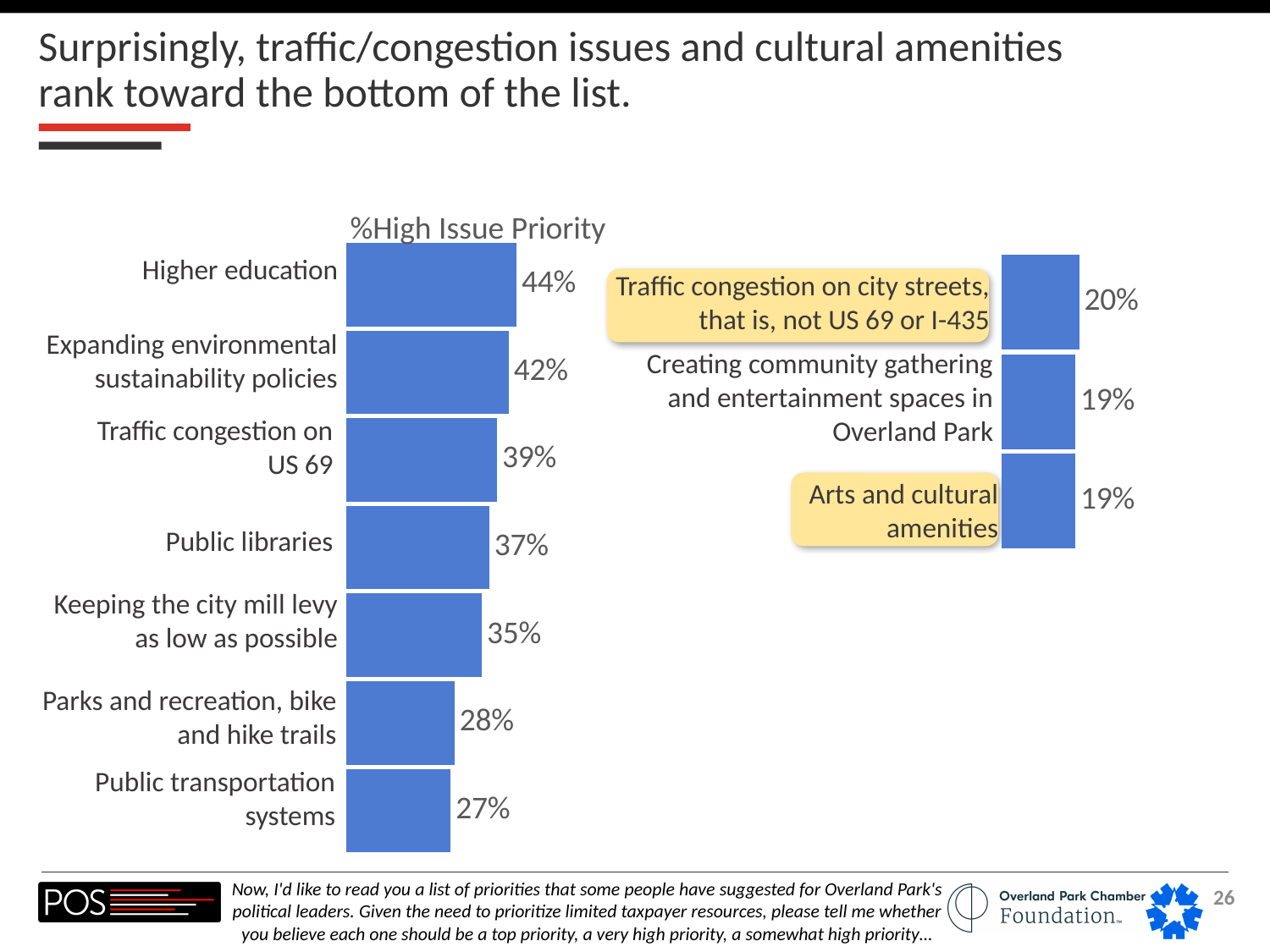
What type of chart is the left chart? Bar chart In the left chart, what is the value for Public libraries? 37% In the left chart, which category has the highest value? Higher education In the right chart, what is the value for Traffic congestion on city streets, that is, not US 69 or I-435? 20% In the left chart, what is the value for Higher education? 44% In the left chart, which is larger: the value for Traffic congestion on US 69 or the value for Keeping the city mill levy as low as possible? Traffic congestion on US 69 How many categories are shown in the left chart? 7 In the right chart, which category has the highest value? Traffic congestion on city streets, that is, not US 69 or I-435 In the right chart, what is the value for Arts and cultural amenities? 19% In the left chart, which category has the lowest value? Public transportation systems In the left chart, what is the difference between the values for Higher education and Public transportation systems? 17% How many categories are shown in the right chart? 3